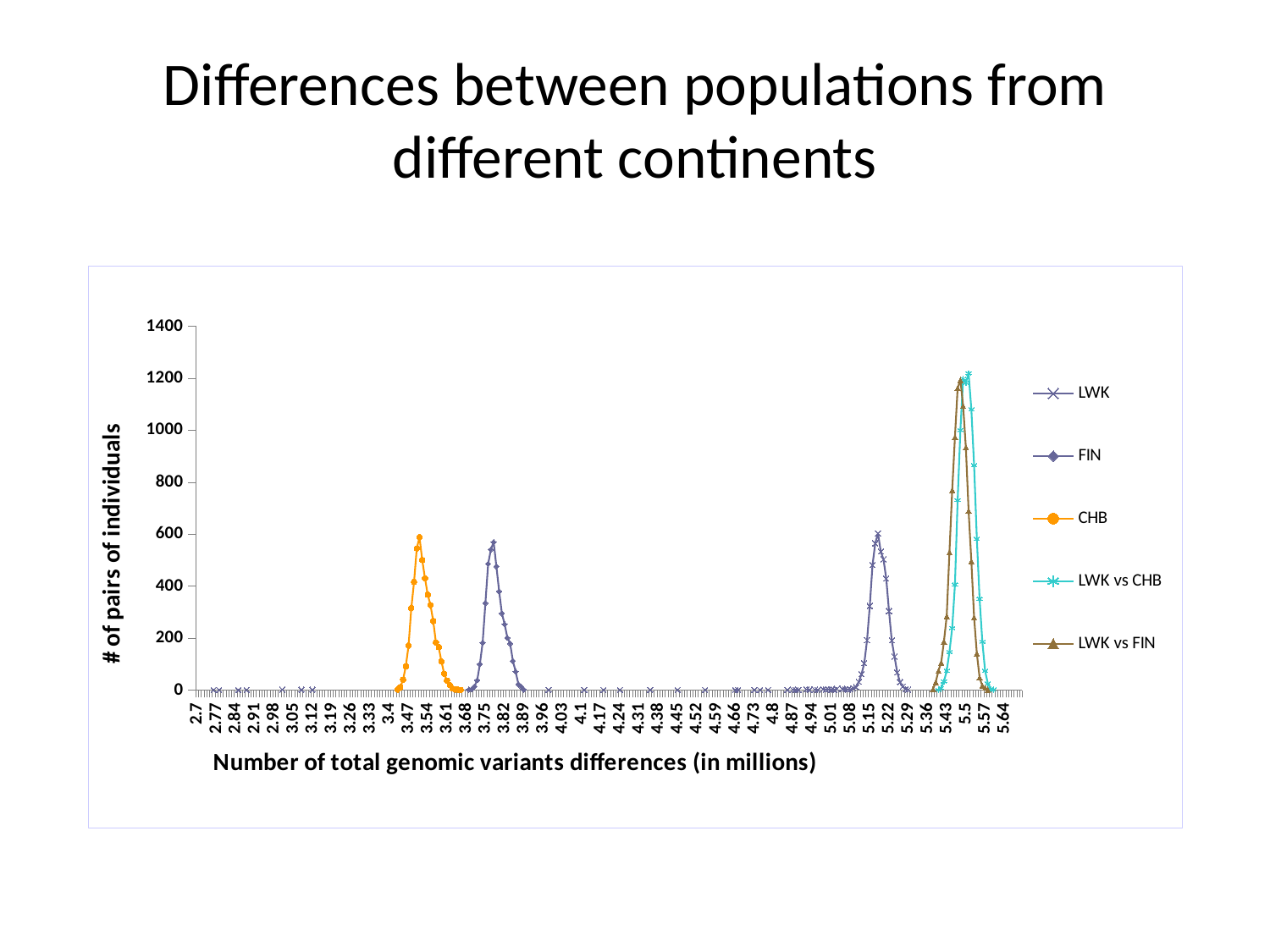
Which series reaches a higher peak, LWK vs CHB or CHB? LWK vs CHB How many series does the legend list? 5 What kind of chart is shown on the slide? line chart Is the peak value of the FIN series greater or less than 400? greater Which series reaches a higher peak, FIN or LWK vs FIN? LWK vs FIN What is the title of the slide's chart? Differences between populations from different continents Is the peak value of the CHB series greater or less than 800? less What is the label of the x axis? Number of total genomic variants differences (in millions) Which series peaks at a lower x-axis value, CHB or LWK? CHB Is the peak value of the LWK vs CHB series greater or less than 1000? greater